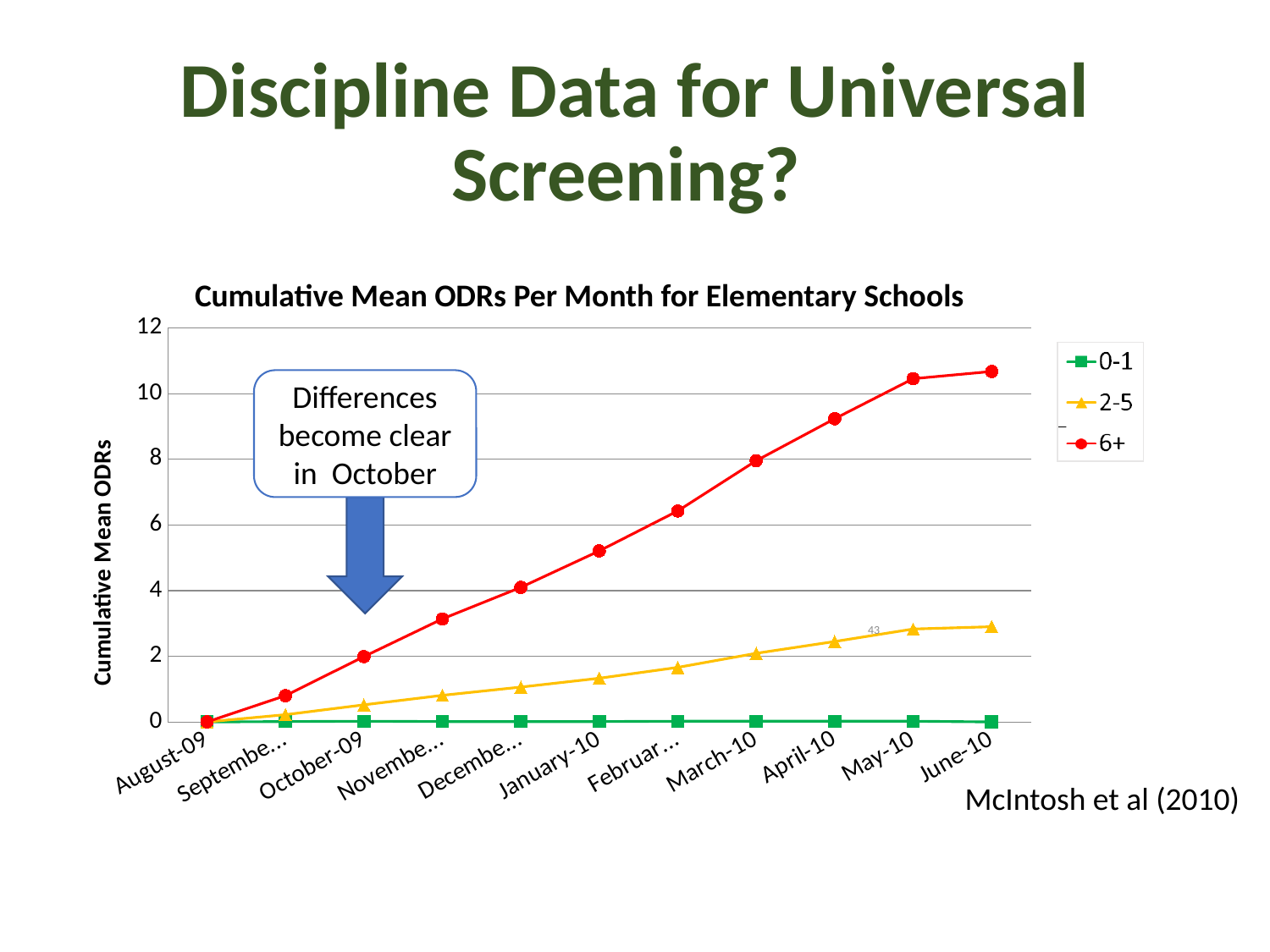
How many months are plotted along the x axis? 11 Is the value for the 6+ series at June-10 greater or less than 10? greater Is the value for the 2-5 series at May-10 greater or less than 4? less Which series has the highest value at June-10? 6+ How many series does the legend list? 3 Does the 6+ series rise or fall from August-09 to June-10? rise Which series has the lowest values across the chart? 0-1 At March-10, which series has the larger value, 6+ or 2-5? 6+ What is the title of the chart? Cumulative Mean ODRs Per Month for Elementary Schools What kind of chart is shown on the slide? line chart Is the value for the 6+ series at April-10 greater or less than 8? greater What is the label on the y axis of the chart? Cumulative Mean ODRs